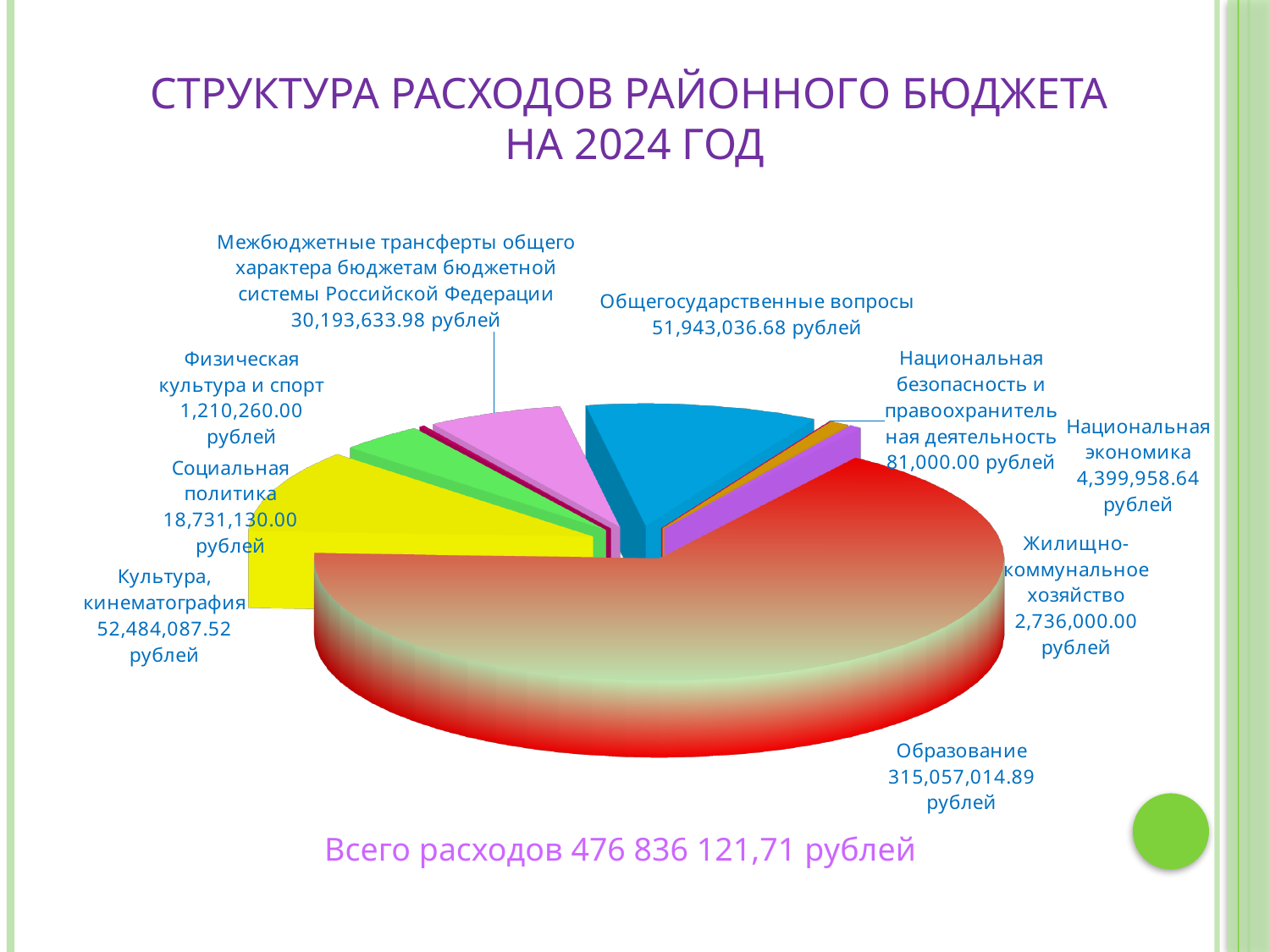
What is the title of the slide? Структура расходов районного бюджета на 2024 год Which category has the largest expenditure? Образование How many expenditure categories are shown in the pie chart? 9 What is the difference between Культура, кинематография and Общегосударственные вопросы? 541,050.84 рублей What is the value for Социальная политика? 18,731,130.00 рублей What is the value for Образование? 315,057,014.89 рублей Which category has the smallest expenditure? Национальная безопасность и правоохранительная деятельность Which is larger: Социальная политика or Национальная экономика? Социальная политика What is the value for Жилищно-коммунальное хозяйство? 2,736,000.00 рублей What kind of chart is shown on the slide? Pie chart What is the value for Общегосударственные вопросы? 51,943,036.68 рублей What is the total expenditure stated on the slide? 476 836 121,71 рублей